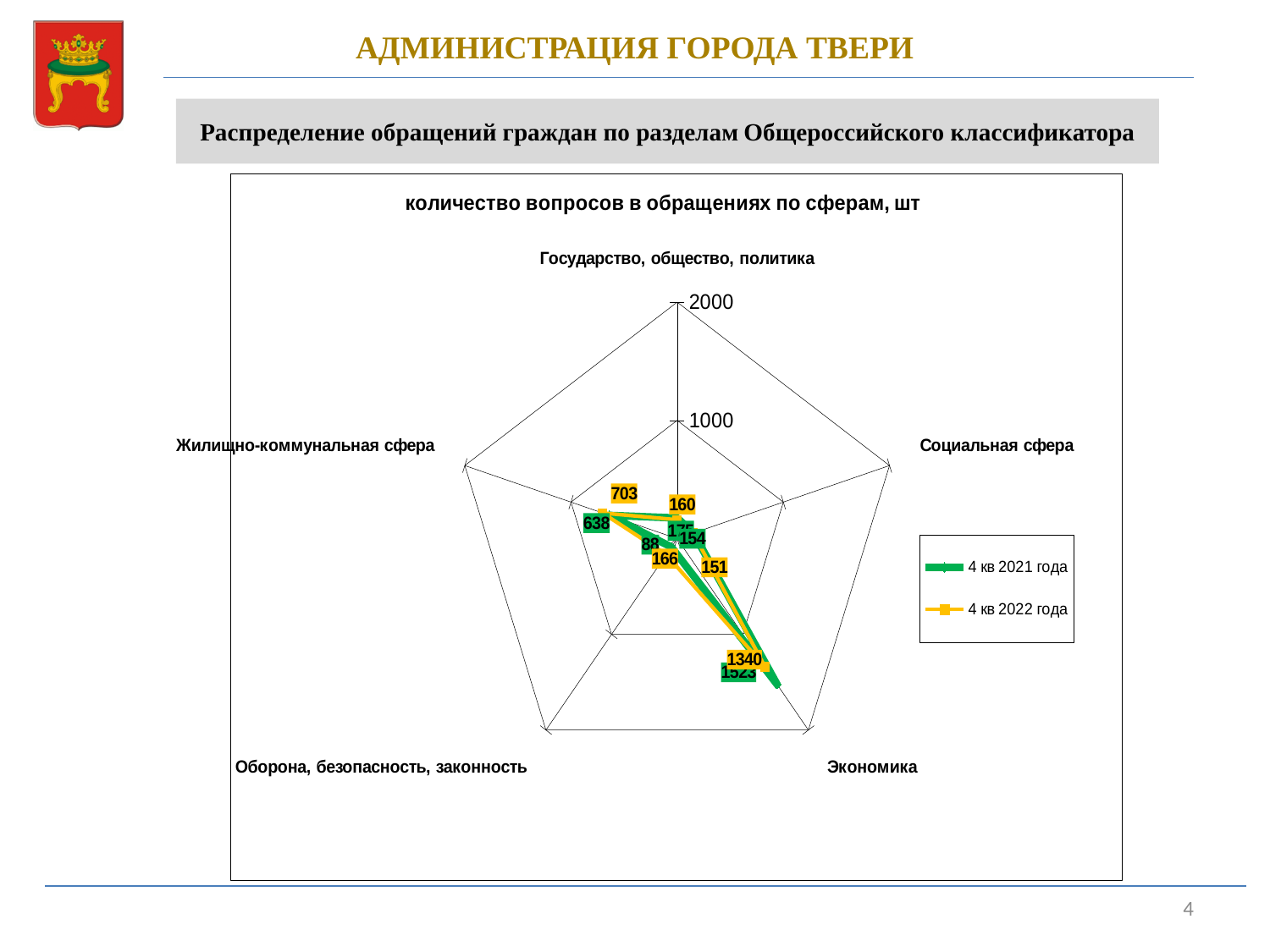
Which category has the highest value for 4 кв 2022 года? Экономика What type of chart is shown on the slide? Radar chart How many series does the legend list? 2 What is the value for Жилищно-коммунальная сфера in 4 кв 2021 года? 638 What is the value for Жилищно-коммунальная сфера in 4 кв 2022 года? 703 What is the value for Экономика in 4 кв 2022 года? 1340 What is the difference between the 4 кв 2022 года and 4 кв 2021 года values for Жилищно-коммунальная сфера? 65 How many categories (axes) does the radar chart have? 5 What is the value for Государство, общество, политика in 4 кв 2022 года? 160 What is the value for Оборона, безопасность, законность in 4 кв 2022 года? 166 Is the value for Экономика in 4 кв 2021 года greater or less than 1000? greater What is the value for Оборона, безопасность, законность in 4 кв 2021 года? 88